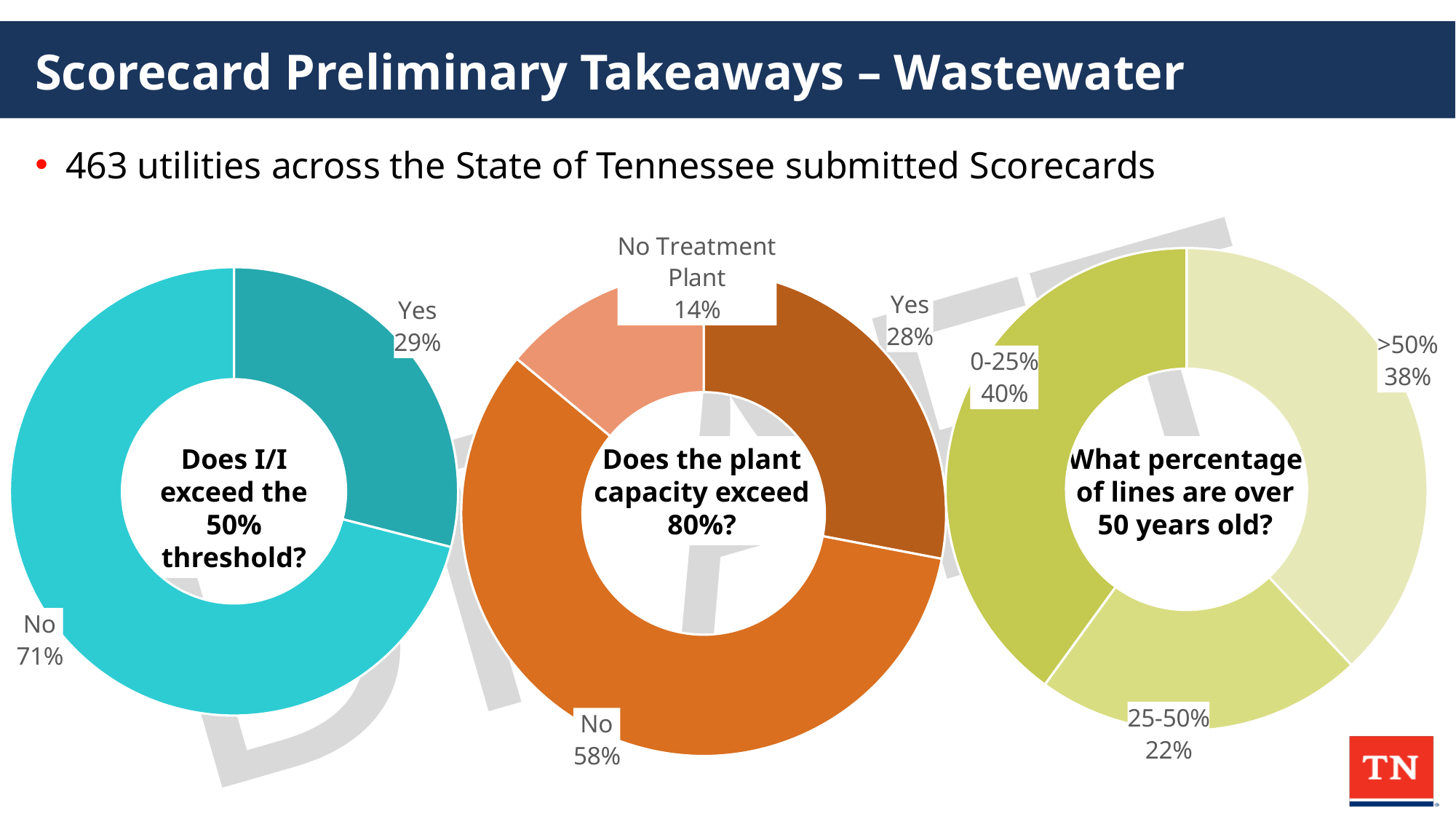
In the 'What percentage of lines are over 50 years old?' chart, which is larger: the 0-25% share or the >50% share? 0-25% In the 'Does the plant capacity exceed 80%?' chart, what share is labelled No Treatment Plant? 14% In the 'Does the plant capacity exceed 80%?' chart, which category has the largest share? No In the 'What percentage of lines are over 50 years old?' chart, which category has the smallest share? 25-50% In the 'What percentage of lines are over 50 years old?' chart, what share is in the 0-25% category? 40% In the 'Does the plant capacity exceed 80%?' chart, what share answered Yes? 28% In the 'Does I/I exceed the 50% threshold?' chart, what share of utilities answered Yes? 29% In the 'Does I/I exceed the 50% threshold?' chart, what is the difference between the No and Yes shares? 42% What kind of chart is used for the 'Does I/I exceed the 50% threshold?' data? Doughnut chart How many categories does the 'Does the plant capacity exceed 80%?' chart show? 3 In the 'Does I/I exceed the 50% threshold?' chart, what share of utilities answered No? 71% In the 'What percentage of lines are over 50 years old?' chart, what share is in the 25-50% category? 22%